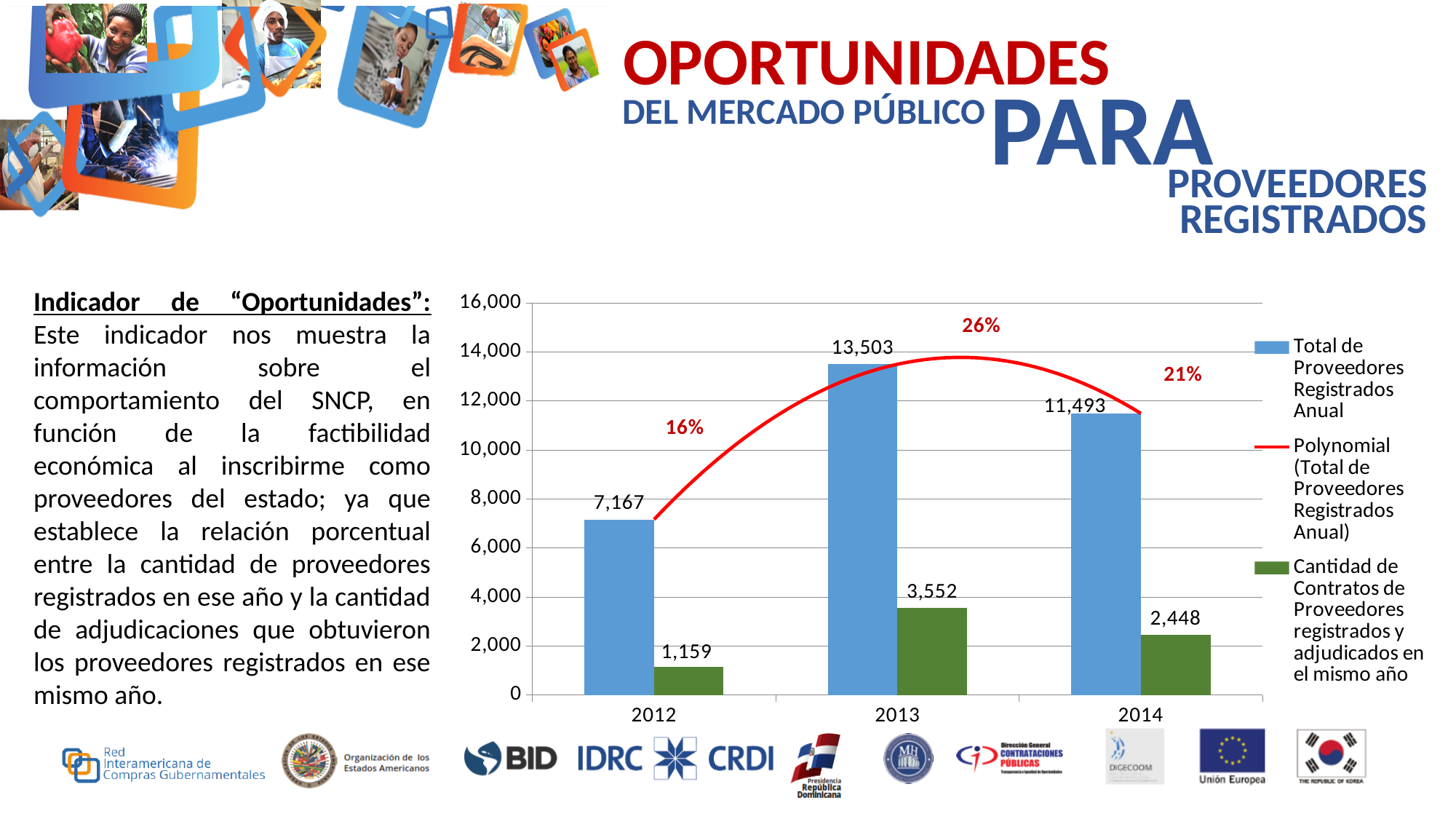
What is the value of Total de Proveedores Registrados Anual for 2014? 11,493 How many entries does the chart legend list? 3 Which year has the lowest value for Cantidad de Contratos de Proveedores registrados y adjudicados en el mismo año? 2012 What is the difference between Total de Proveedores Registrados Anual in 2013 and in 2012? 6,336 What is the value of Cantidad de Contratos de Proveedores registrados y adjudicados en el mismo año for 2012? 1,159 What is the value of Total de Proveedores Registrados Anual for 2013? 13,503 Which year has the highest value for Total de Proveedores Registrados Anual? 2013 Which is larger: Cantidad de Contratos in 2013 or in 2014? 2013 What kind of chart is shown on the slide? bar chart Is the value for Total de Proveedores Registrados Anual in 2012 greater or less than 8,000? less What percentage label is shown above the 2013 bars on the chart? 26% How many years are shown on the x axis of the chart? 3